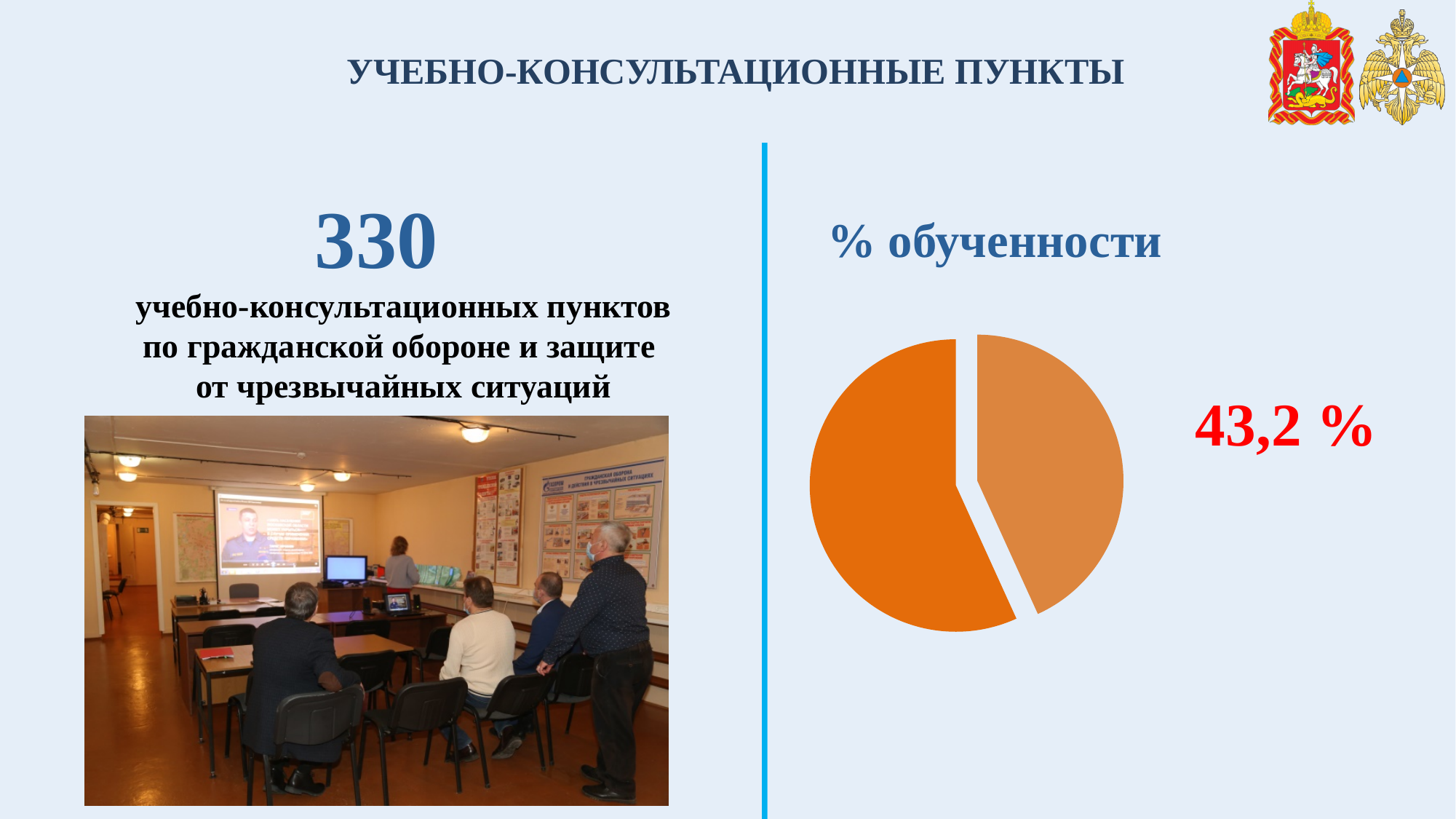
How many slices does the pie chart have? 2 Is the lighter orange slice of the pie chart greater or less than half of the pie? less What percentage value is printed next to the pie chart? 43,2 % What is the title shown above the pie chart? % обученности Which slice of the pie chart is pulled out (exploded) from the rest of the pie? the lighter orange slice Does the pie chart have a legend? No Which slice of the pie chart is larger, the darker orange slice or the lighter orange slice? the darker orange slice What kind of chart is shown on the slide? pie chart